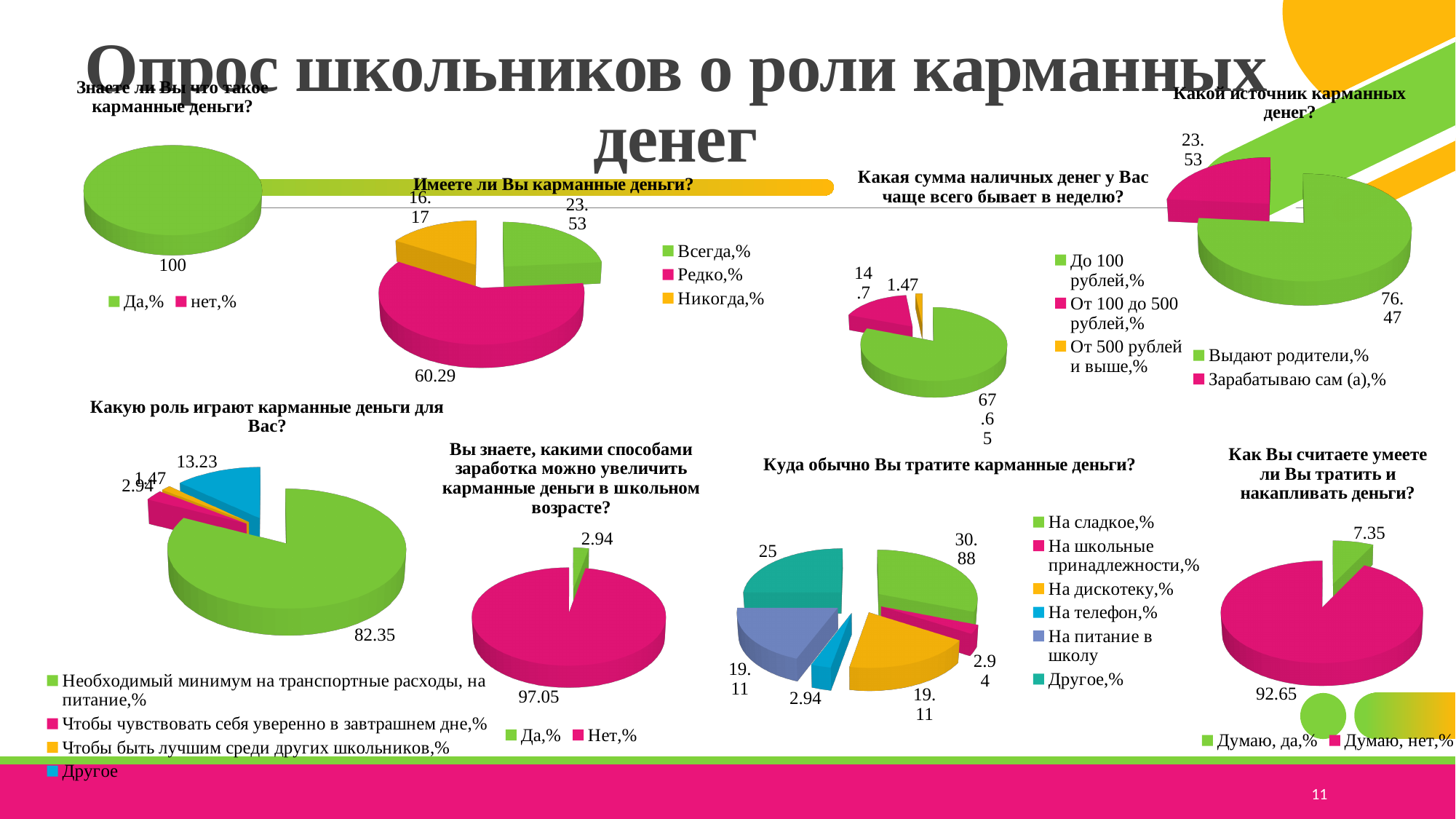
In the chart 'Какой источник карманных денег?', what is the difference between 'Выдают родители,%' and 'Зарабатываю сам (а),%'? 52.94 In the chart 'Какая сумма наличных денег у Вас чаще всего бывает в неделю?', which category has the highest value? До 100 рублей,% In the chart 'Куда обычно Вы тратите карманные деньги?', how many categories does the legend list? 6 In the chart 'Как Вы считаете умеете ли Вы тратить и накапливать деньги?', what is the value for 'Думаю, нет,%'? 92.65 In the chart 'Куда обычно Вы тратите карманные деньги?', what is the value for 'На сладкое,%'? 30.88 In the chart 'Куда обычно Вы тратите карманные деньги?', which is larger: 'Другое,%' or 'На дискотеку,%'? Другое,% In the chart 'Имеете ли Вы карманные деньги?', what is the value for 'Редко,%'? 60.29 In the chart 'Какая сумма наличных денег у Вас чаще всего бывает в неделю?', what is the value for 'От 500 рублей и выше,%'? 1.47 What type of chart is used for 'Какую роль играют карманные деньги для Вас?'? Pie chart In the chart 'Вы знаете, какими способами заработка можно увеличить карманные деньги в школьном возрасте?', what is the value for 'Да,%'? 2.94 In the chart 'Имеете ли Вы карманные деньги?', which category has the lowest value? Никогда,% In the chart 'Какой источник карманных денег?', what is the value for 'Выдают родители,%'? 76.47